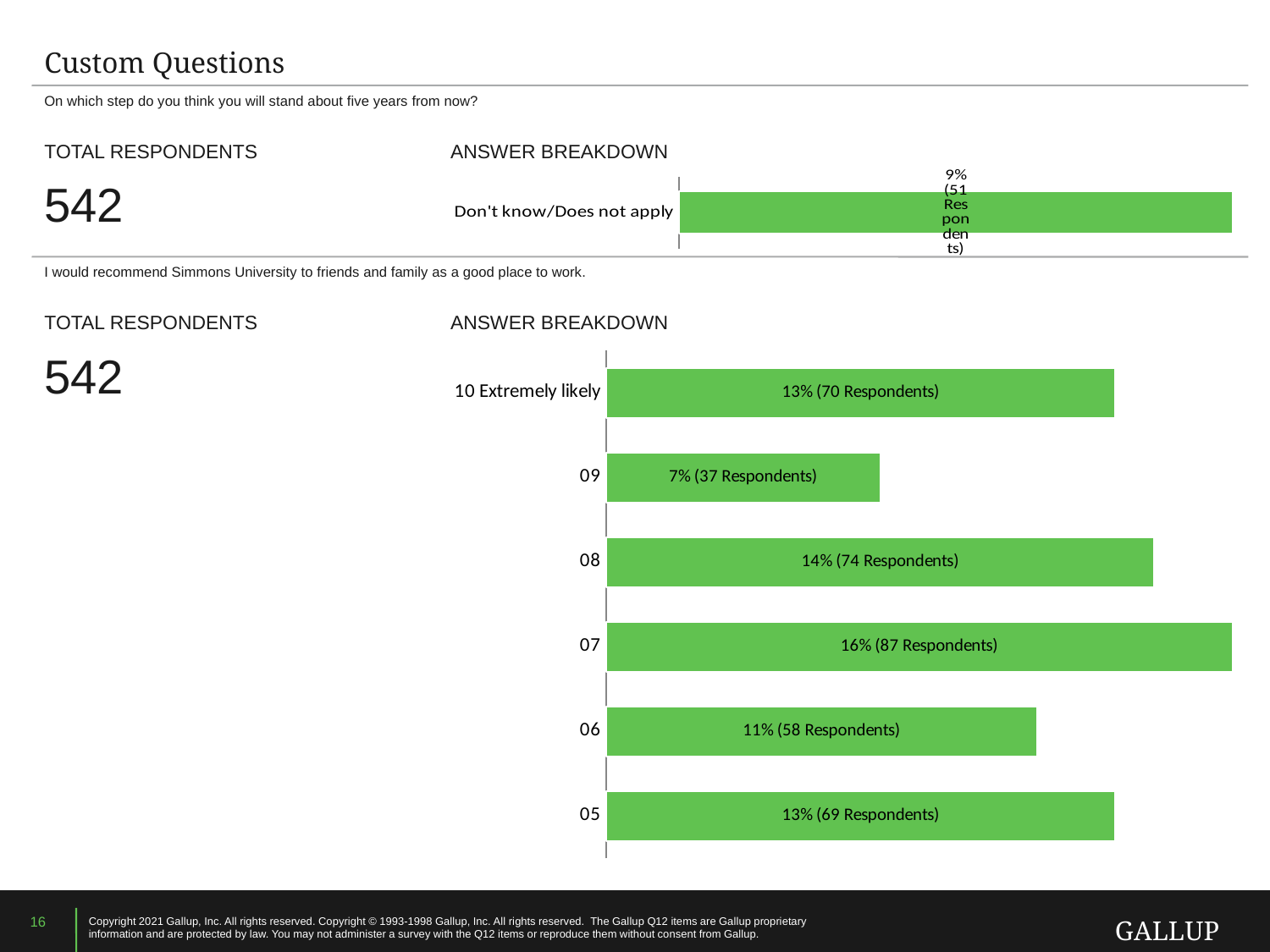
What type of chart is the bottom chart? bar chart In the top chart, what percentage is shown for Don't know/Does not apply? 9% In the bottom chart, what is the data label for 10 Extremely likely? 13% (70 Respondents) In the bottom chart, which category has the lowest percentage? 09 How many categories are shown in the bottom chart? 6 In the top chart, how many respondents answered Don't know/Does not apply? 51 In the bottom chart, what is the difference in respondents between 07 and 09? 50 What is the total number of respondents shown for the bottom question? 542 In the bottom chart, how many respondents chose 09? 37 In the bottom chart, what percentage of respondents chose 07? 16% In the bottom chart, which has more respondents, 08 or 06? 08 In the bottom chart, which category has the highest percentage? 07